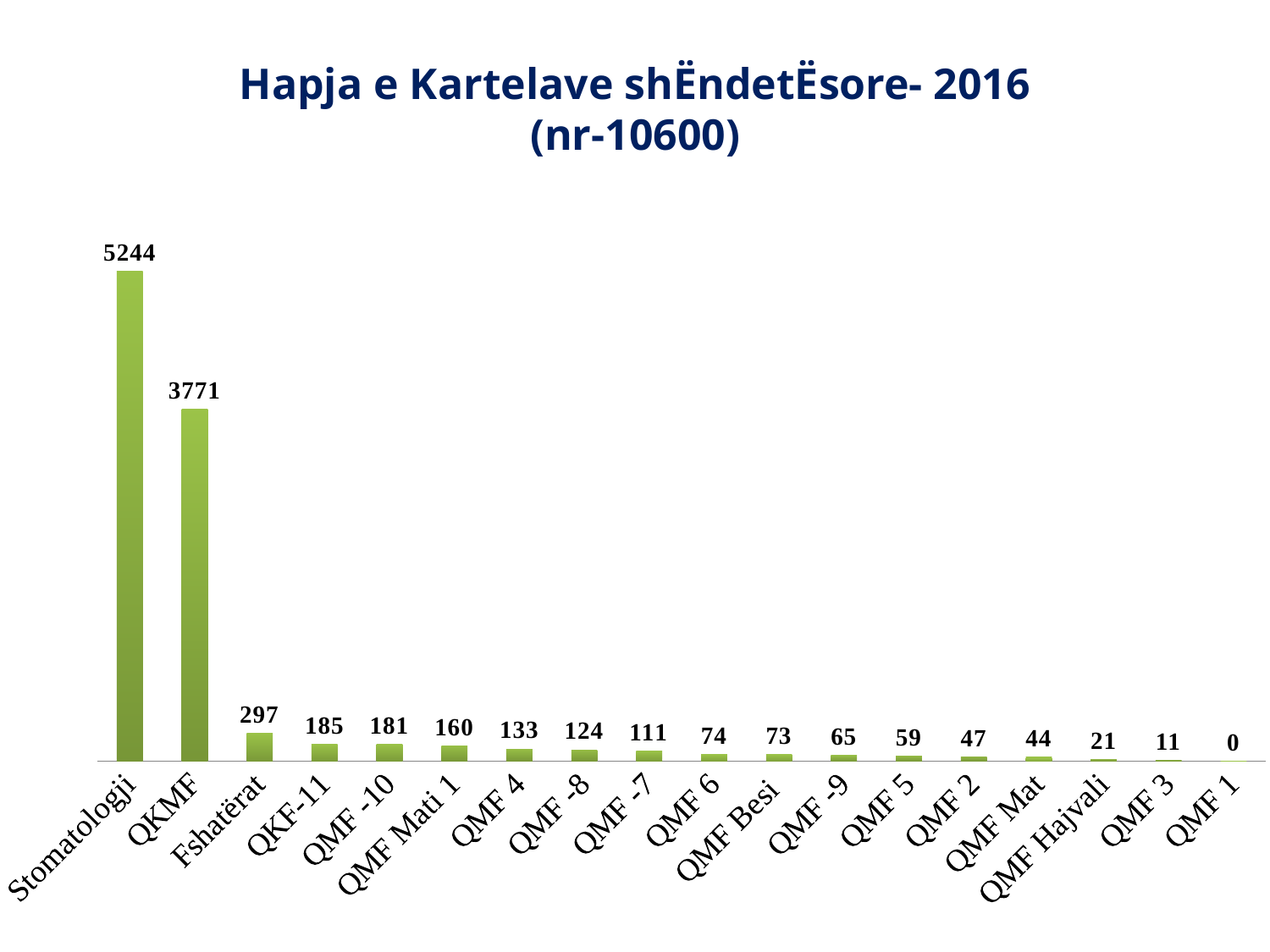
How many categories are shown on the x axis? 18 What is the value for QKMF? 3771 Which category has the lowest value? QMF 1 What is the value for Stomatologji? 5244 Which category has the highest value? Stomatologji What is the value for QMF Besi? 73 What is the difference between the values for Stomatologji and QKMF? 1473 What is the value for QMF Hajvali? 21 Which is larger, the value for QKF-11 or the value for QMF -10? QKF-11 What is the title of the chart? Hapja e Kartelave shËndetËsore- 2016 (nr-10600) What kind of chart is shown on the slide? Bar chart What is the value for Fshatërat? 297